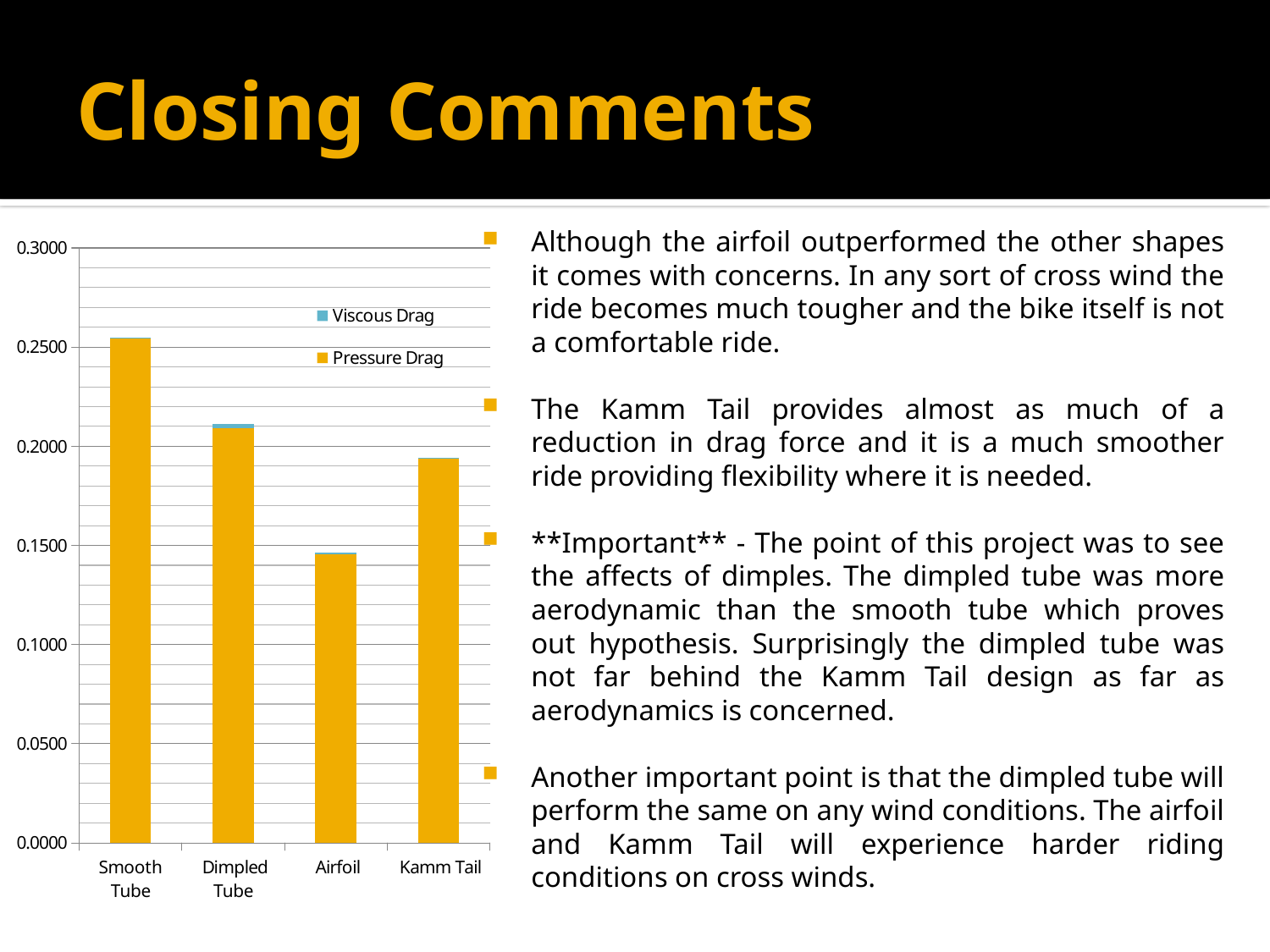
Is the total value for Smooth Tube greater or less than 0.2000? greater Which category has the tallest bar in the chart? Smooth Tube Which bar is taller, Dimpled Tube or Kamm Tail? Dimpled Tube Is the total value for Airfoil greater or less than 0.1000? greater How many categories are shown on the x axis of the chart? 4 Is the total value for Kamm Tail greater or less than 0.2000? less How many series does the chart legend list? 2 What are the two series named in the chart legend? Viscous Drag and Pressure Drag What kind of chart is shown on the slide? Bar chart Which category has the shortest bar in the chart? Airfoil Which series makes up almost all of each bar in the chart? Pressure Drag Which bar is taller, Smooth Tube or Dimpled Tube? Smooth Tube